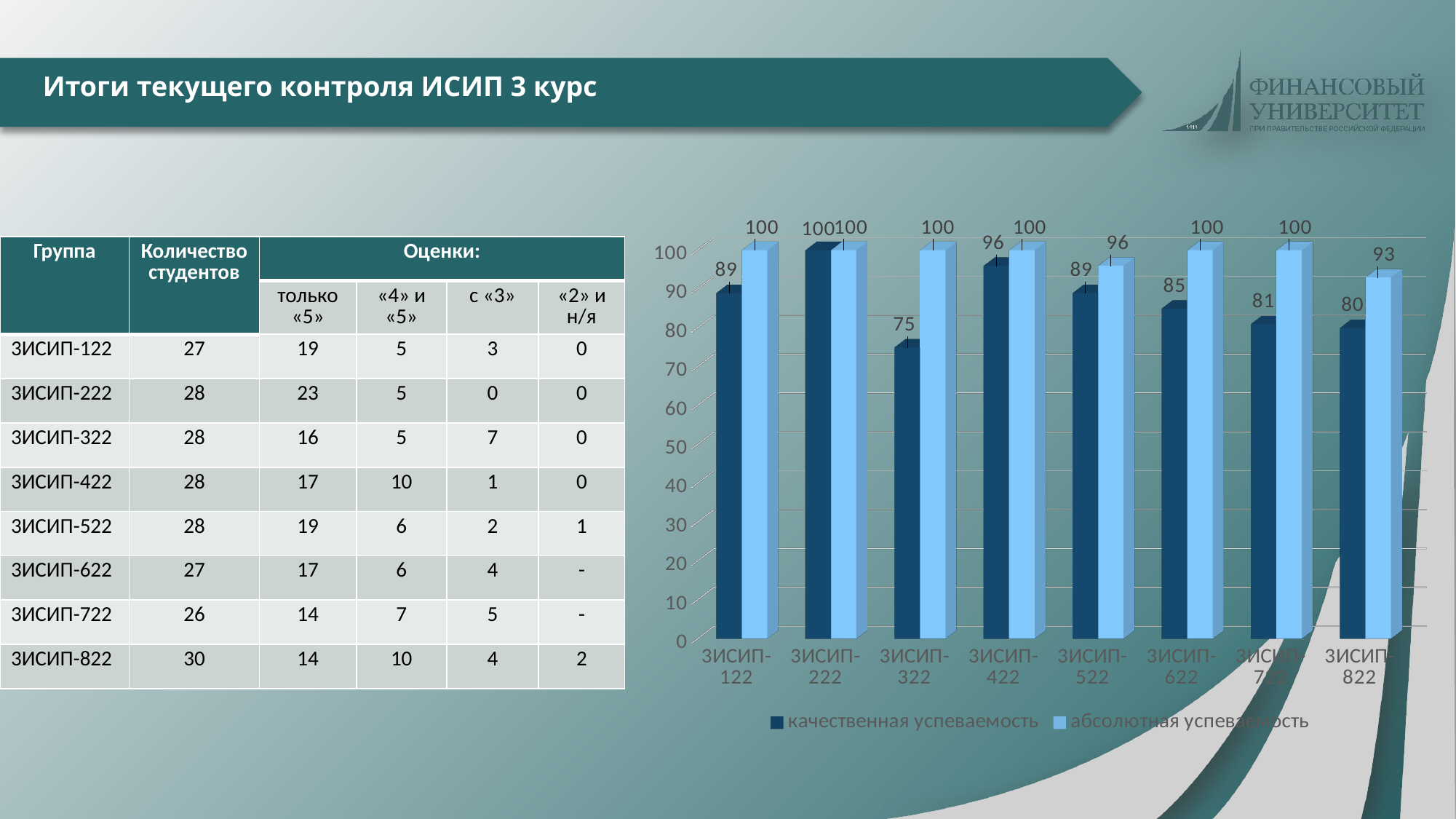
What is the value of качественная успеваемость for ЗИСИП-322? 75 Which group has the highest качественная успеваемость? ЗИСИП-222 Which group has the lowest абсолютная успеваемость? ЗИСИП-822 What is the value of абсолютная успеваемость for ЗИСИП-822? 93 Which group has the lowest качественная успеваемость? ЗИСИП-322 How many series does the chart legend list? 2 Which series is shown in dark blue in the chart legend? качественная успеваемость What is the difference between абсолютная успеваемость and качественная успеваемость for ЗИСИП-722? 19 How many groups (categories) are shown on the x axis of the chart? 8 What type of chart is shown on the slide? bar chart What is the value of качественная успеваемость for ЗИСИП-622? 85 Which is larger: качественная успеваемость for ЗИСИП-422 or for ЗИСИП-522? ЗИСИП-422